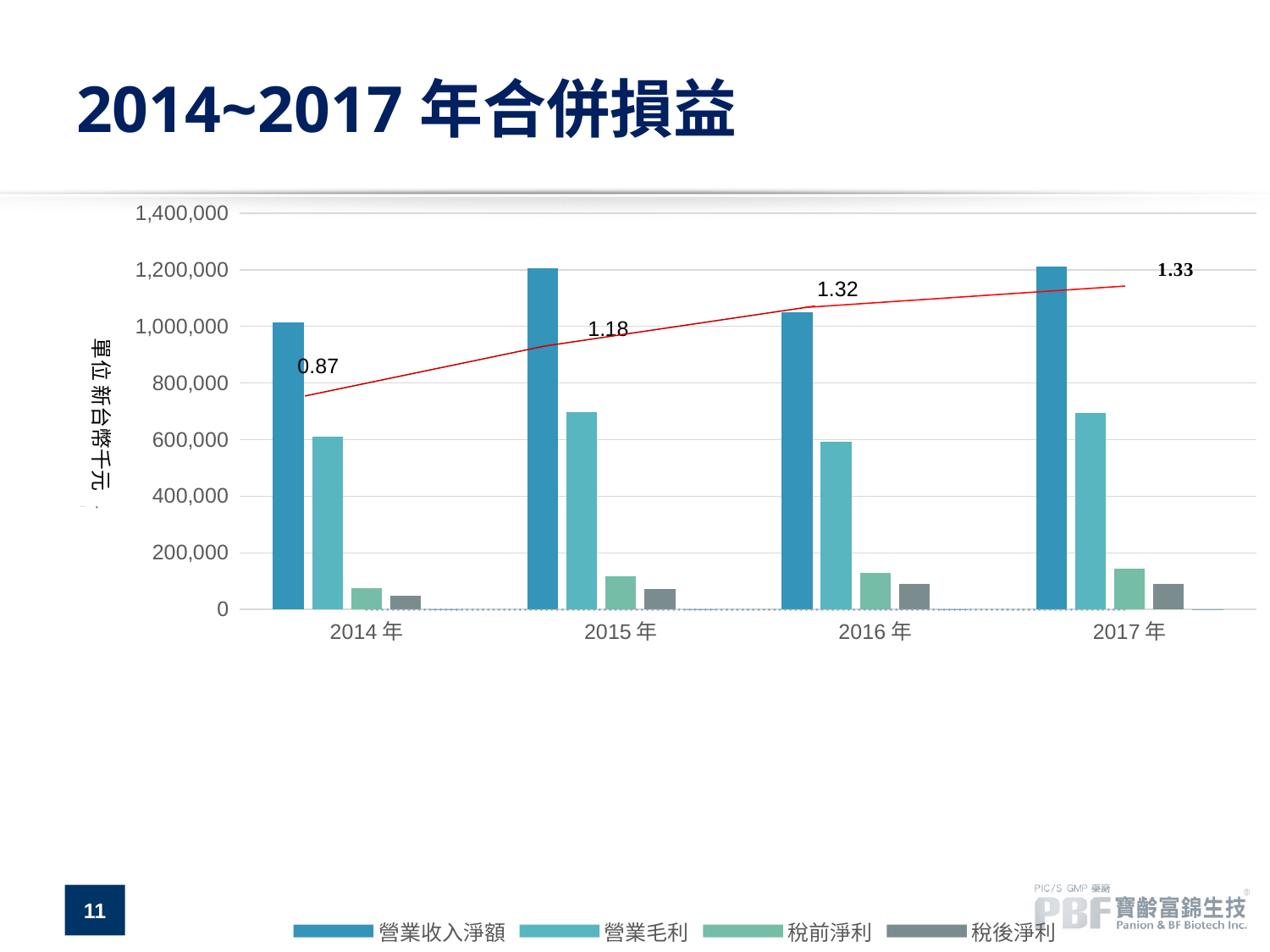
Is the 營業收入淨額 value for 2016 年 greater or less than 1,000,000? greater In which year does the red line have its lowest labelled value? 2014 年 Which is larger, the 營業毛利 bar for 2015 年 or for 2016 年? 2015 年 Which year has the lowest 營業收入淨額 bar? 2014 年 What value is labelled on the red line for 2014 年? 0.87 Do the red line's labelled values rise or fall from 2014 年 to 2017 年? rise What value is labelled on the red line for 2016 年? 1.32 What value is labelled on the red line for 2017 年? 1.33 How many series does the legend list? 4 In which year does the red line reach its highest labelled value? 2017 年 Is the 營業毛利 value for 2015 年 greater or less than 800,000? less What is the difference between the red line's labelled values for 2017 年 and 2014 年? 0.46